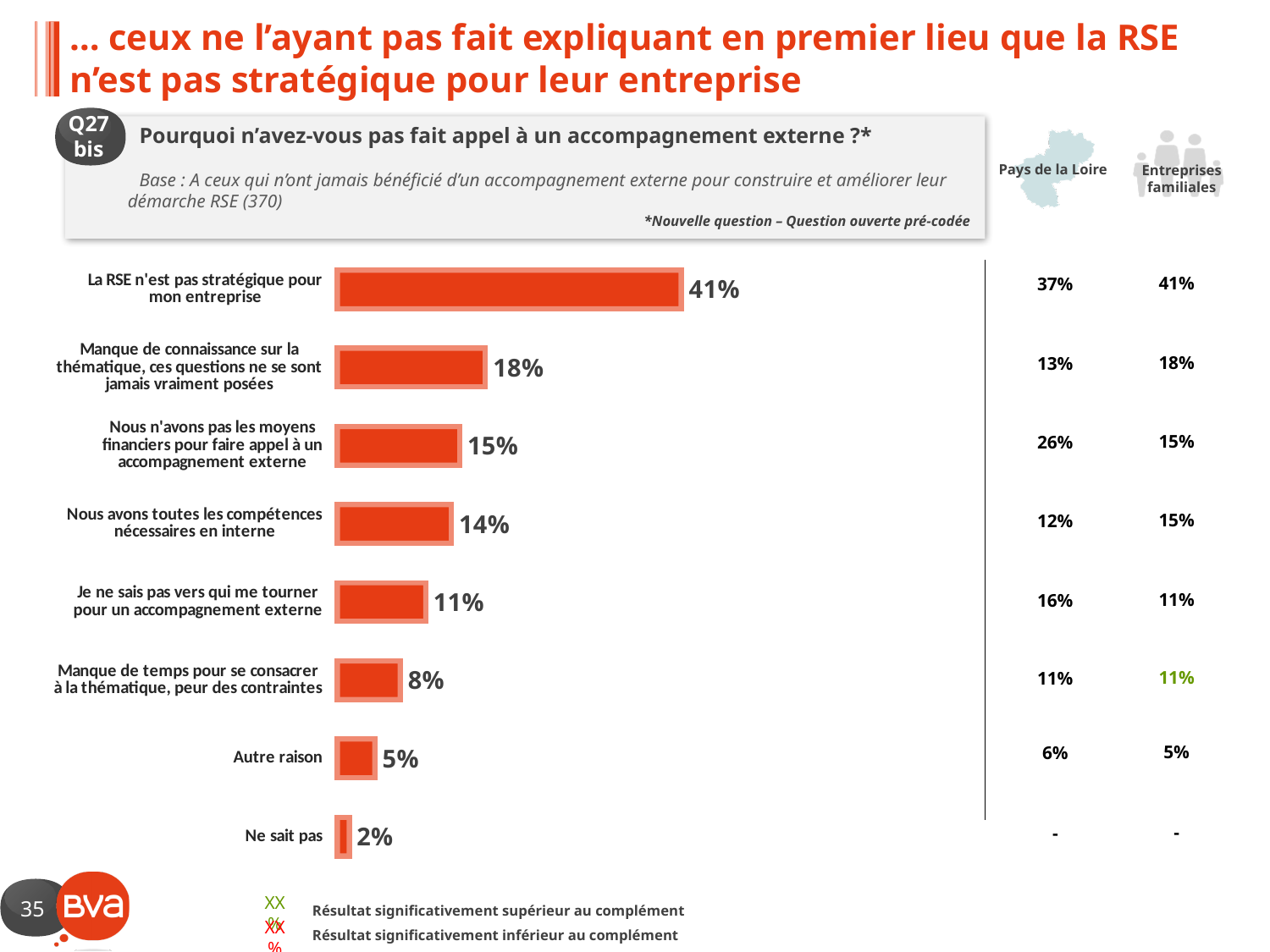
What is the difference between the value for "La RSE n'est pas stratégique pour mon entreprise" and the value for "Manque de connaissance sur la thématique, ces questions ne se sont jamais vraiment posées"? 23 percentage points What kind of chart is shown on the slide? Bar chart What is the value shown for "Autre raison"? 5% Which is larger: the value for "Nous n'avons pas les moyens financiers pour faire appel à un accompagnement externe" or the value for "Je ne sais pas vers qui me tourner pour un accompagnement externe"? Nous n'avons pas les moyens financiers pour faire appel à un accompagnement externe What is the value shown for "Nous avons toutes les compétences nécessaires en interne"? 14% What is the value shown for "Ne sait pas"? 2% What is the value shown for "Manque de temps pour se consacrer à la thématique, peur des contraintes"? 8% Which reason has the highest value in the chart? La RSE n'est pas stratégique pour mon entreprise What is the base (number of respondents) stated for the question shown in the chart? 370 How many categories are plotted in the bar chart? 8 Which category has the lowest value in the chart? Ne sait pas What percentage of respondents said "La RSE n'est pas stratégique pour mon entreprise"? 41%